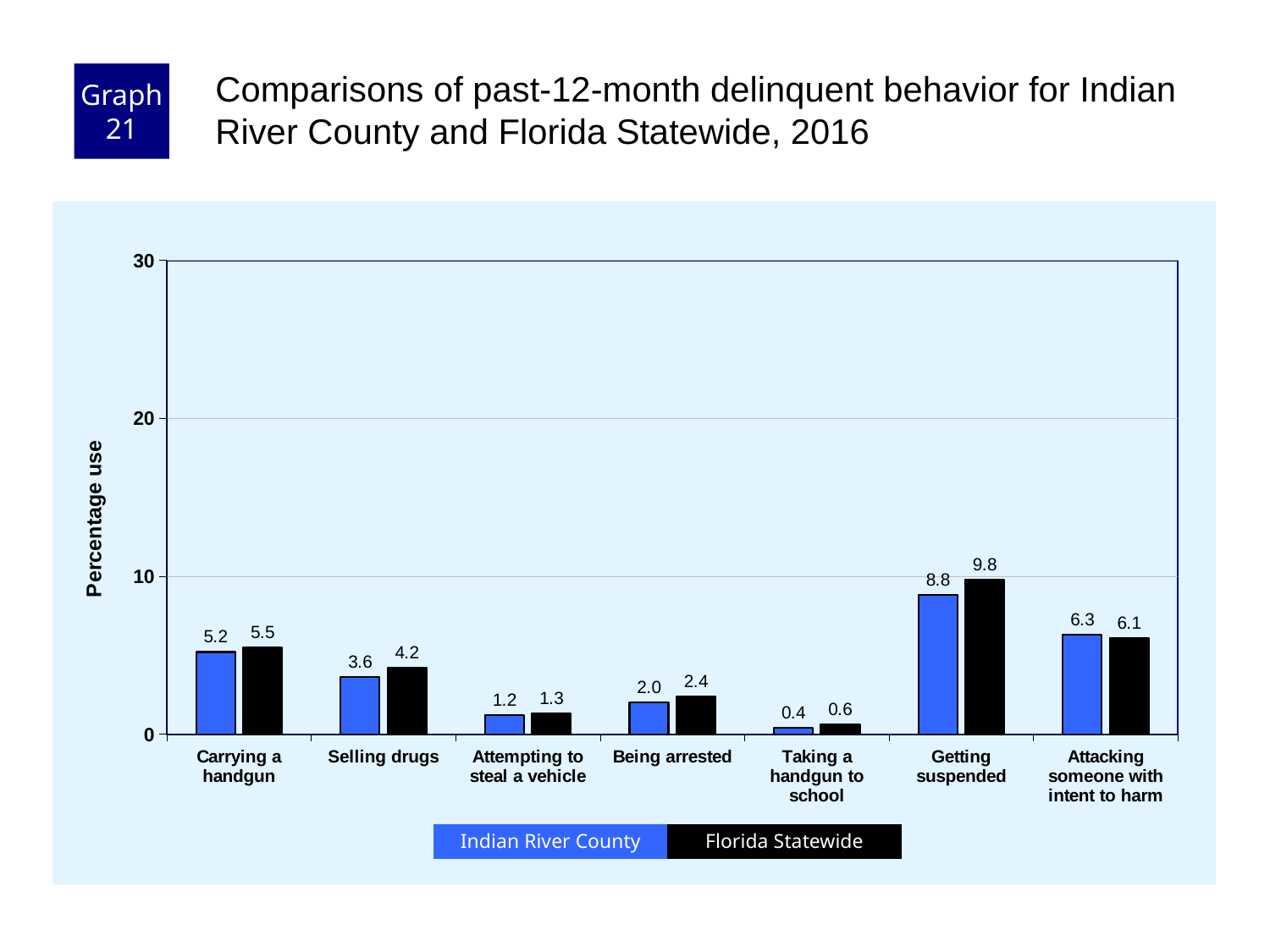
What is the difference between the Florida Statewide and Indian River County values for Selling drugs? 0.6 What is the Indian River County value for Getting suspended? 8.8 How many behavior categories are shown on the x axis? 7 What type of chart is shown on the slide? Bar chart Which behavior has the lowest Indian River County value? Taking a handgun to school What is the Florida Statewide value for Selling drugs? 4.2 For Attacking someone with intent to harm, which is larger: Indian River County or Florida Statewide? Indian River County For Being arrested, which is larger: Indian River County or Florida Statewide? Florida Statewide Which behavior has the highest Florida Statewide value? Getting suspended What is the difference between the Florida Statewide and Indian River County values for Getting suspended? 1.0 How many series does the legend list? 2 What is the Indian River County value for Taking a handgun to school? 0.4